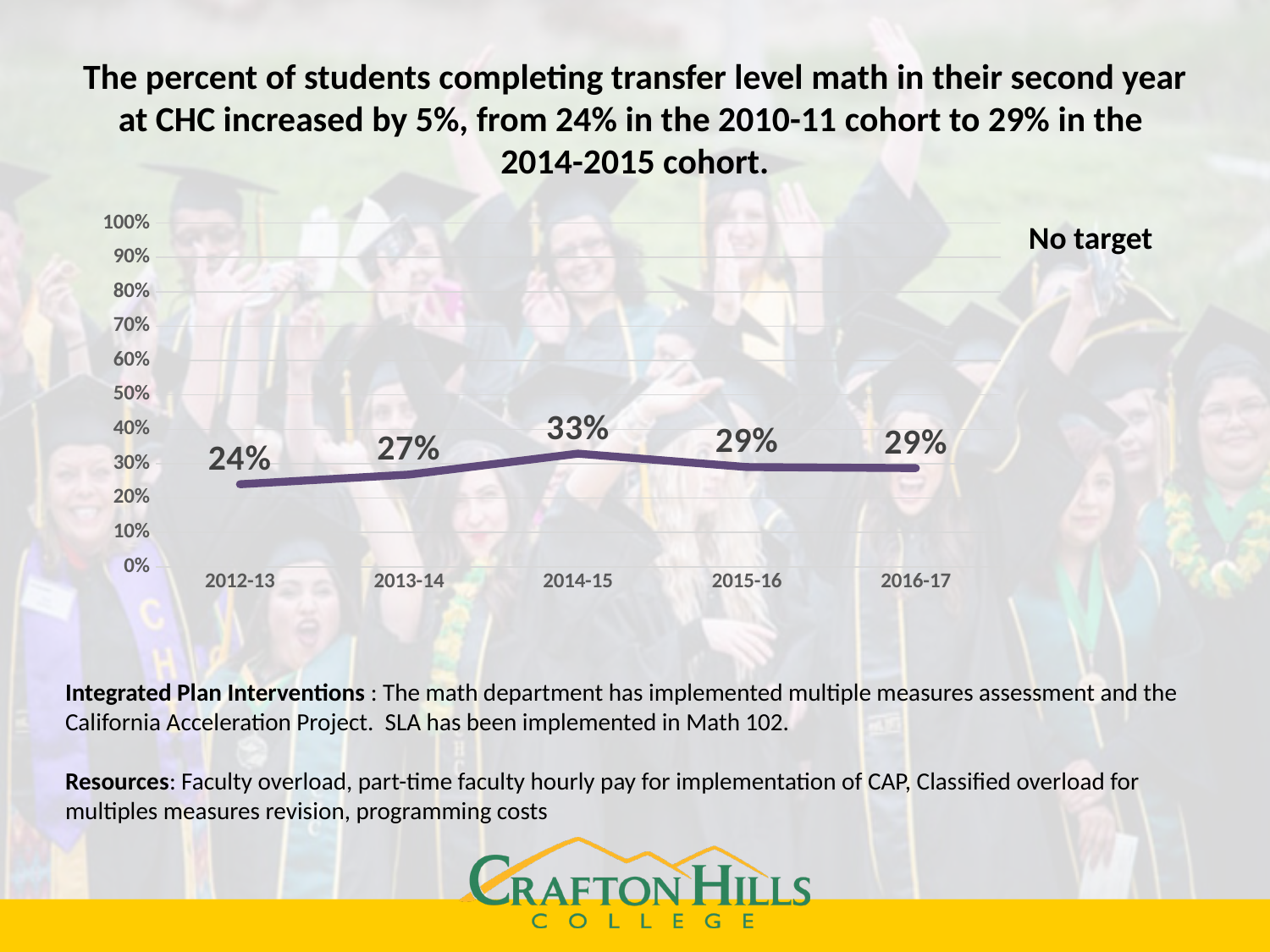
Do the values rise or fall from 2012-13 to 2014-15? rise What is the value for 2012-13? 24% What text appears in the upper right of the chart area? No target Which is larger, the value for 2013-14 or the value for 2015-16? 2015-16 What is the value for 2016-17? 29% What is the value for 2014-15? 33% What kind of chart is shown on the slide? line chart Is the value for 2014-15 greater or less than 30%? greater Which year has the highest value? 2014-15 What is the difference between the values for 2014-15 and 2012-13? 9% Which year has the lowest value? 2012-13 How many years are plotted on the chart? 5